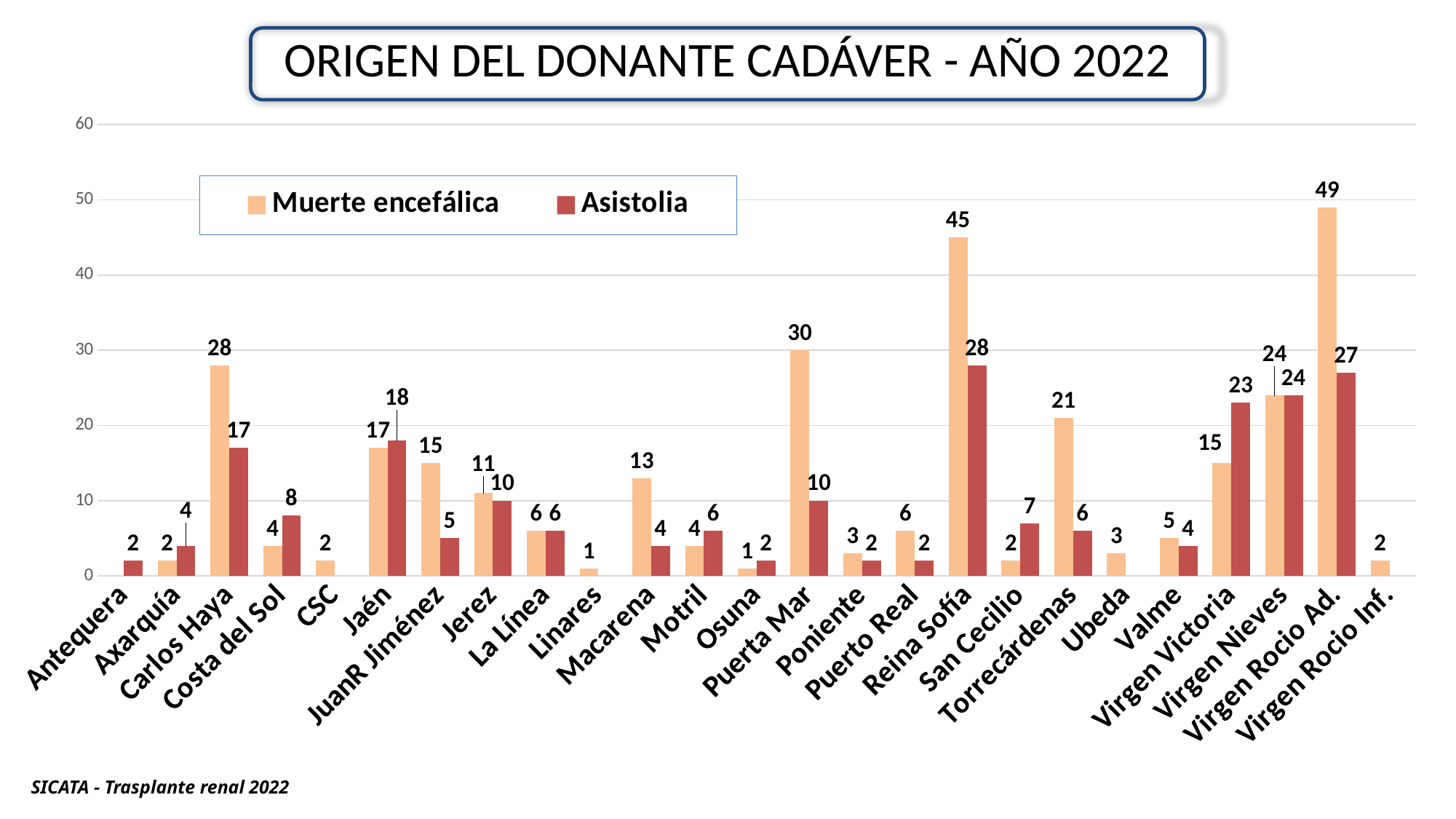
Which category has the highest Muerte encefálica value? Virgen Rocio Ad. Which is larger for Costa del Sol: Muerte encefálica or Asistolia? Asistolia Which category has the highest Asistolia value? Reina Sofía Is the Muerte encefálica value for Virgen Rocio Ad. greater or less than 40? greater What is the Muerte encefálica value for Reina Sofía? 45 What is the Asistolia value for Virgen Victoria? 23 What kind of chart is shown on the slide? Bar chart How many series does the legend list? 2 What is the difference between the Muerte encefálica and Asistolia values for Carlos Haya? 11 What is the Muerte encefálica value for Puerta Mar? 30 How many categories are shown on the x axis? 25 What is the title of the chart? ORIGEN DEL DONANTE CADÁVER - AÑO 2022